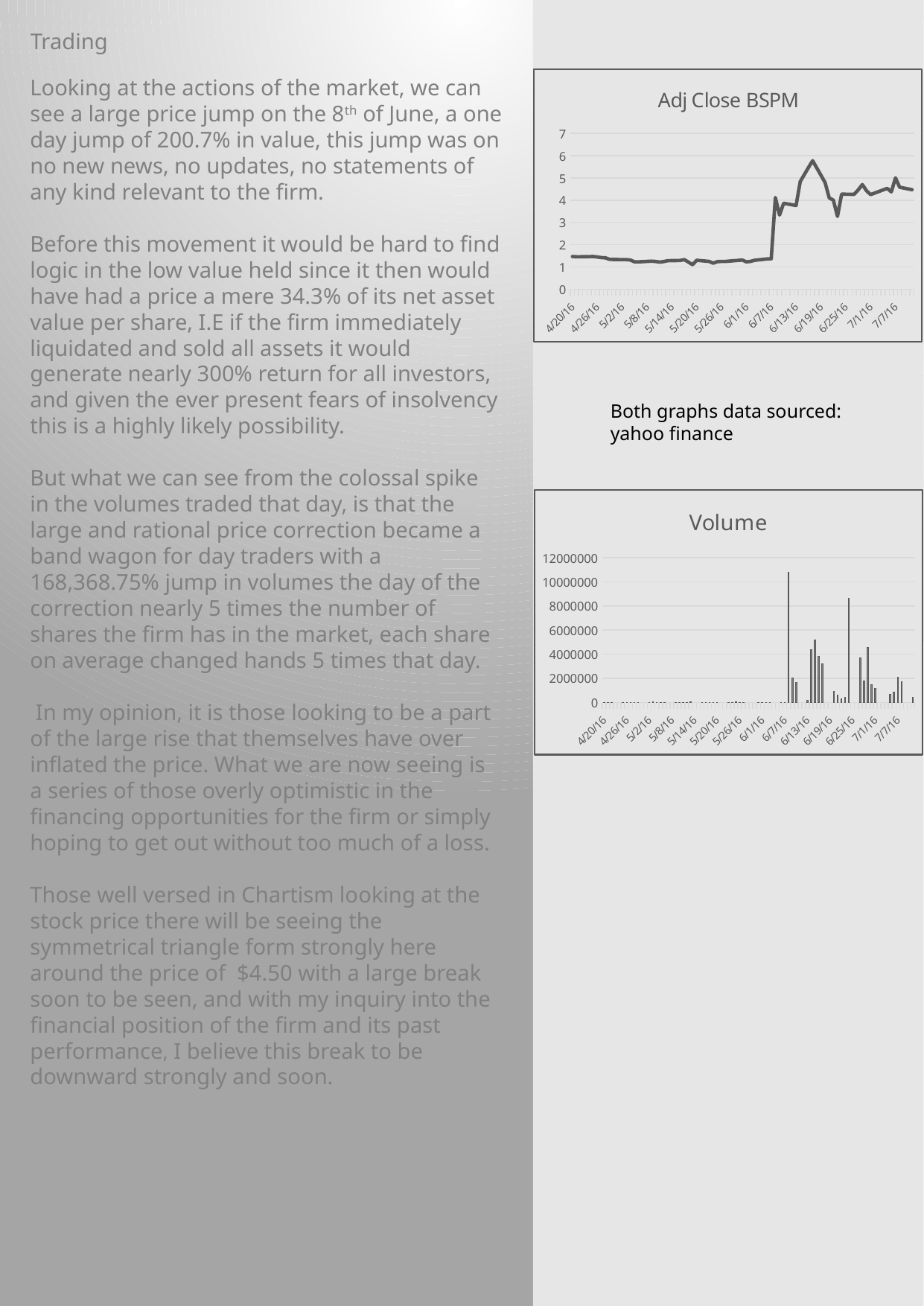
In the "Volume" chart, is the tallest bar located before or after 6/1/16 on the x axis? after In the "Adj Close BSPM" chart, is the value at 5/14/16 greater or less than 3? less In the "Volume" chart, is the bar at 5/2/16 greater or less than 2000000? less What type of chart is the "Adj Close BSPM" chart? line chart What is the title of the upper chart on the slide? Adj Close BSPM What type of chart is the "Volume" chart? bar chart What is the title of the lower chart on the slide? Volume In the "Adj Close BSPM" chart, is the value at 7/7/16 greater or less than 4? greater In the "Adj Close BSPM" chart, does the value overall rise or fall from 4/20/16 to 7/7/16? rise